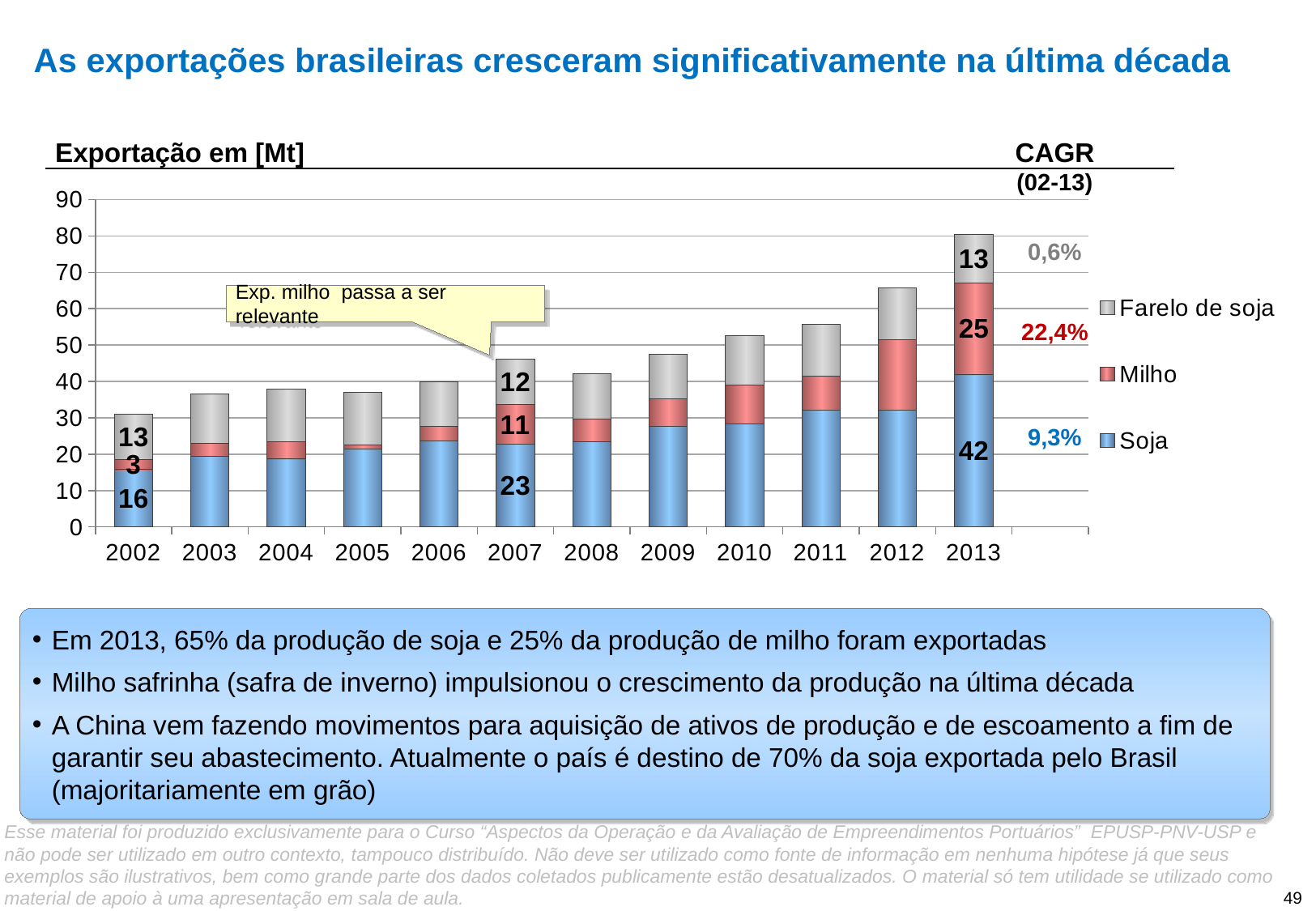
What is the total of the stacked bar for 2013? 80 How many years are shown on the x axis? 12 What is the total of the stacked bar for 2002? 31 What is the value for Soja in 2013? 42 What is the difference between the Soja value in 2013 and the Soja value in 2002? 26 What is the value for Farelo de soja in 2002? 13 What CAGR (02-13) is shown for Milho? 22,4% How many series does the legend list? 3 What is the value for Milho in 2007? 11 Is the total value for 2012 greater or less than 60? greater Which year has the highest total exports? 2013 What kind of chart is shown on the slide? Stacked bar chart